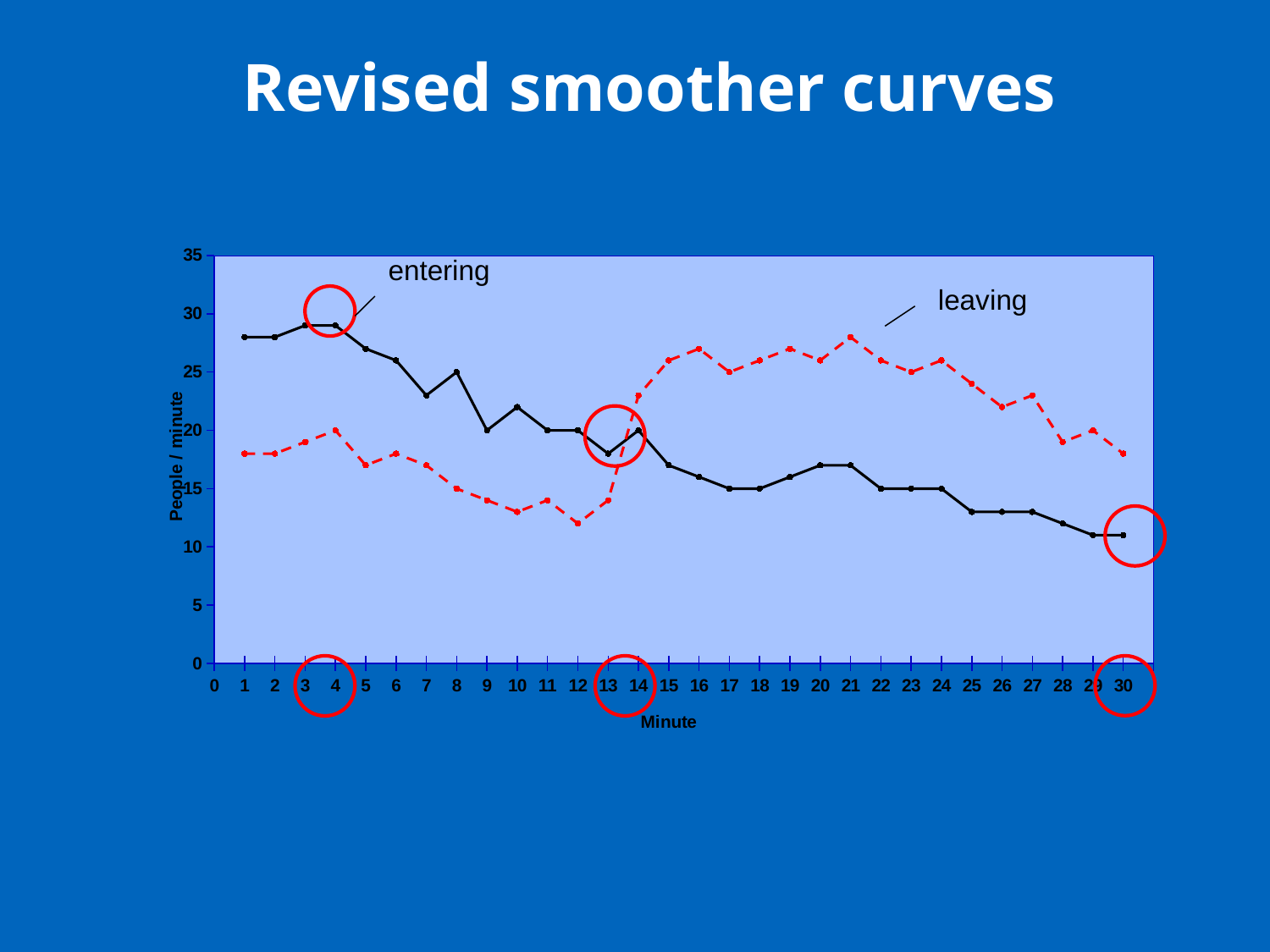
What are the names of the two series plotted on the chart? entering and leaving What kind of chart is shown on the slide? line chart How many data points does the entering series have (minutes 1 to 30)? 30 Is the value for entering at minute 30 greater or less than 15? less Is the value for leaving at minute 12 greater or less than 15? less At minute 1, which series has the larger value, entering or leaving? entering What is the title of the y axis? People / minute Does the leaving series rise or fall between minute 12 and minute 16? rise Does the entering series generally rise or fall from minute 1 to minute 30? fall Is the value for leaving at minute 21 greater or less than 25? greater At minute 20, which series has the larger value, entering or leaving? leaving How many series are plotted on the chart? 2